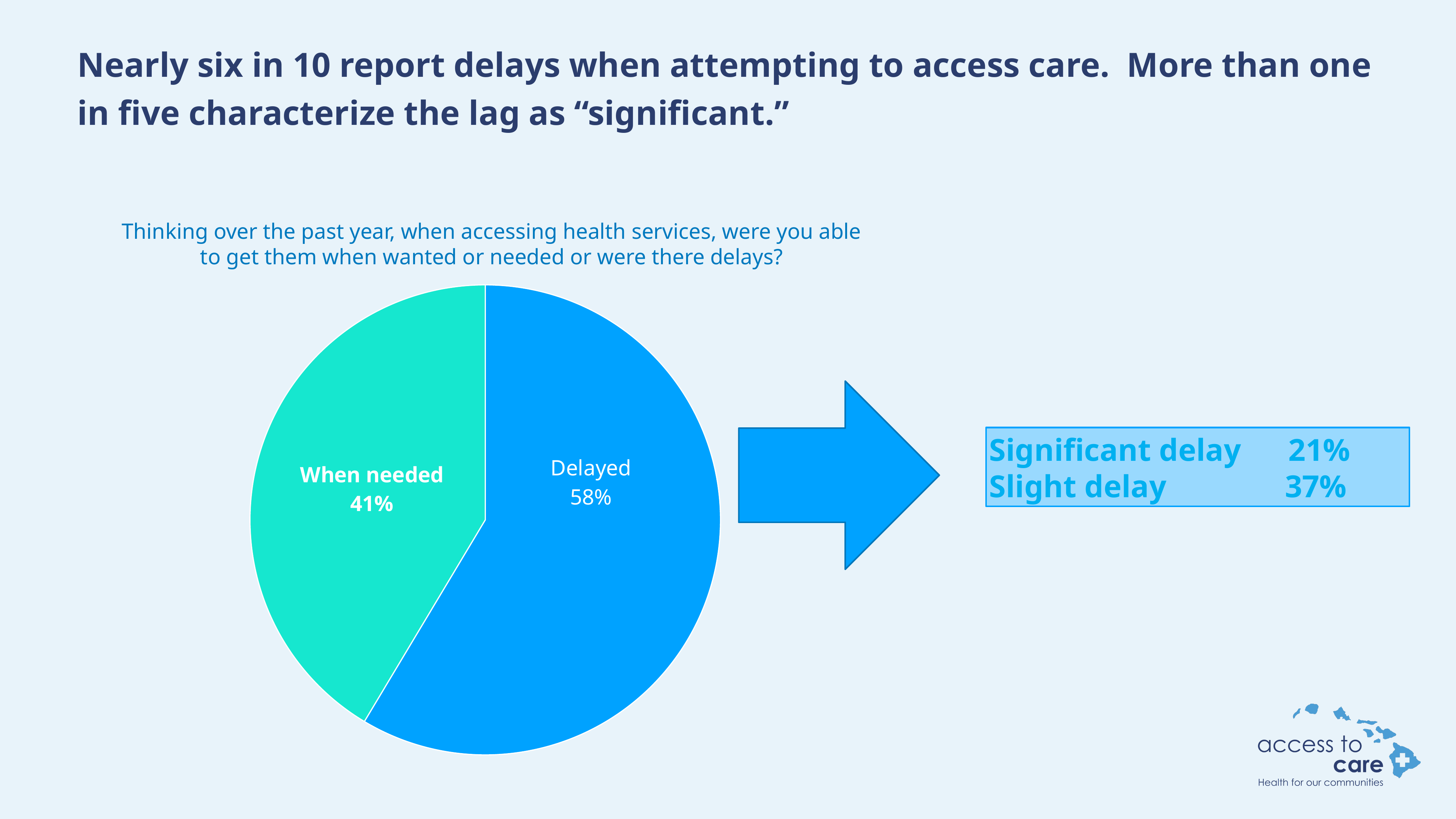
What percentage of respondents said they got health services when needed? 41% Which slice of the pie chart is the largest? Delayed According to the breakdown box, what percentage reported a significant delay? 21% Which slice of the pie chart is the smallest? When needed What share of the pie does the Delayed slice represent? 58% According to the breakdown box, what percentage reported a slight delay? 37% What is the difference in percentage points between the Delayed and When needed slices? 17 What percentage of respondents reported delays when accessing health services? 58% What kind of chart is shown on the slide? Pie chart What colour is the When needed slice of the pie chart? Teal/green How many slices does the pie chart have? 2 Which is larger, the Delayed slice or the When needed slice? Delayed